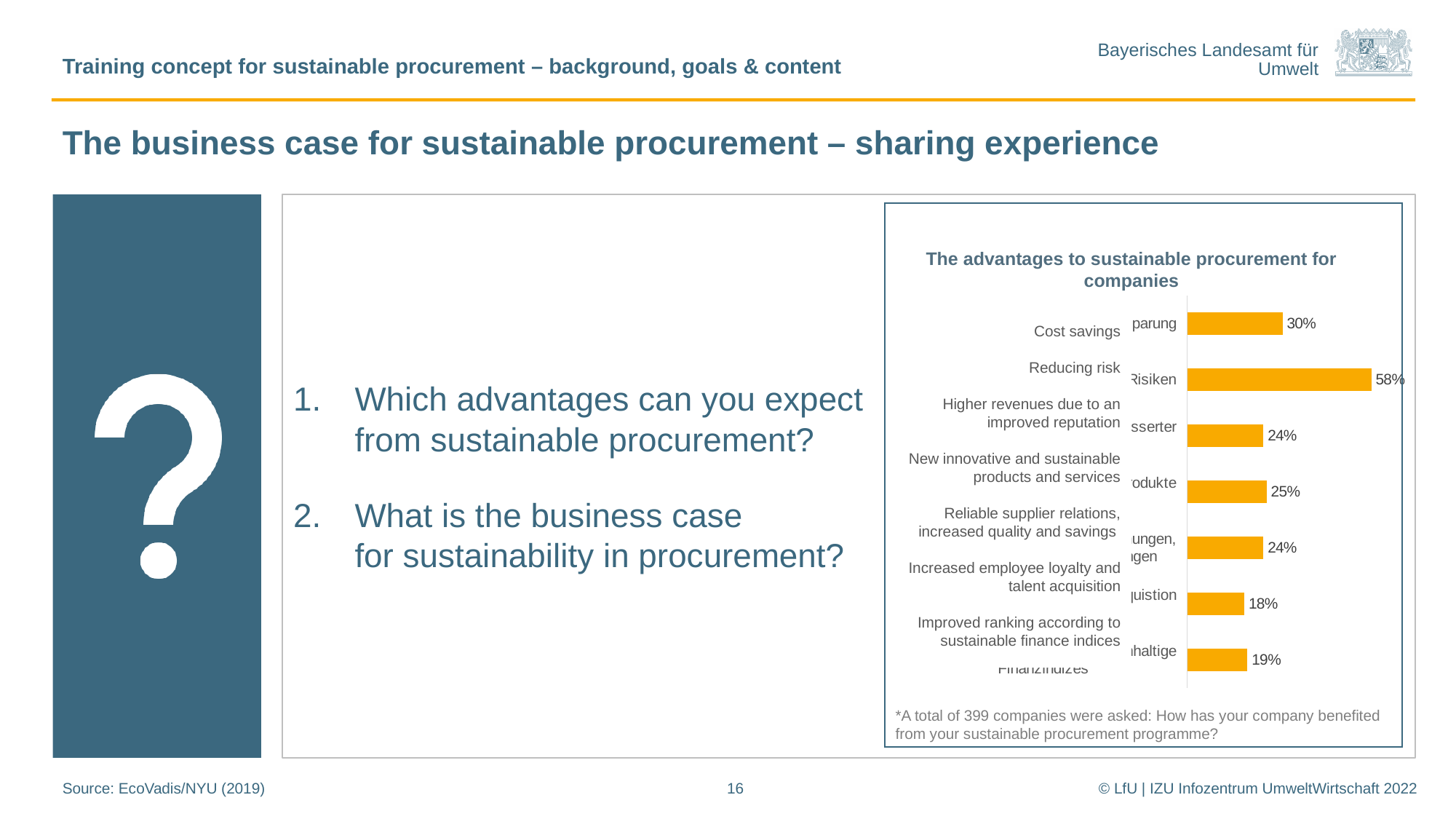
What kind of chart is shown on the slide? Bar chart Which category has the lowest value? Increased employee loyalty and talent acquisition What is the value for Reducing risk? 58% What is the value for Increased employee loyalty and talent acquisition? 18% What is the title of the chart? The advantages to sustainable procurement for companies What is the value for Improved ranking according to sustainable finance indices? 19% Which category has the highest value? Reducing risk How many categories are shown in the chart? 7 What is the value for Cost savings? 30% Which is larger, the value for Cost savings or the value for Higher revenues due to an improved reputation? Cost savings What is the value for New innovative and sustainable products and services? 25% What is the difference between the values for Reducing risk and Cost savings? 28%